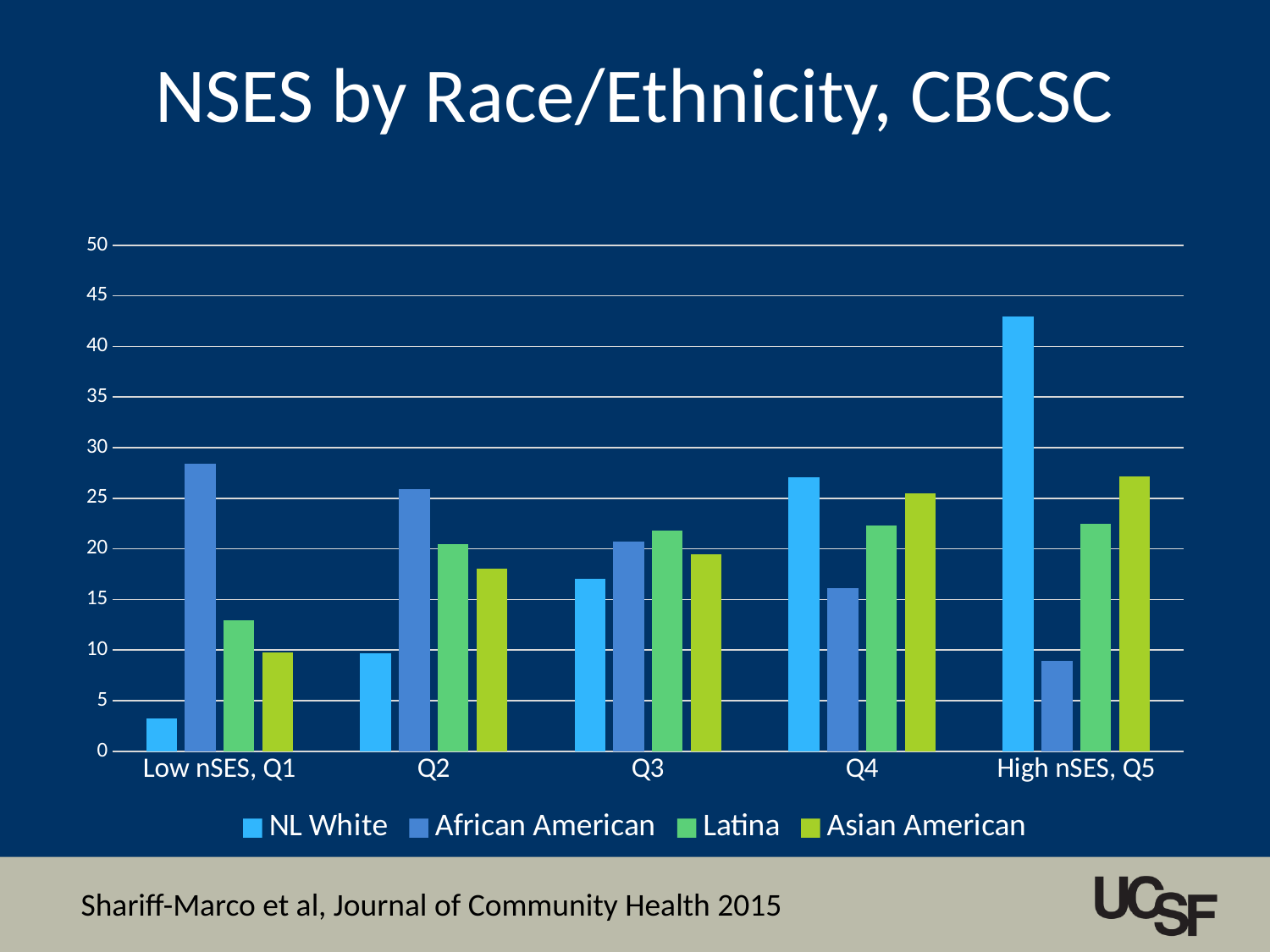
In which nSES category is the African American bar lowest? High nSES, Q5 What kind of chart is shown on the slide? bar chart At Q4, which is larger: the NL White value or the African American value? NL White In which nSES category is the NL White bar highest? High nSES, Q5 What is the title of the chart? NSES by Race/Ethnicity, CBCSC Do the NL White values rise or fall from Low nSES, Q1 to High nSES, Q5? rise Is the value for African American at Low nSES, Q1 greater or less than 25? greater Is the value for NL White at High nSES, Q5 greater or less than 40? greater How many nSES categories are shown along the x axis? 5 In which nSES category is the NL White bar lowest? Low nSES, Q1 In which nSES category is the African American bar highest? Low nSES, Q1 How many series does the legend list? 4